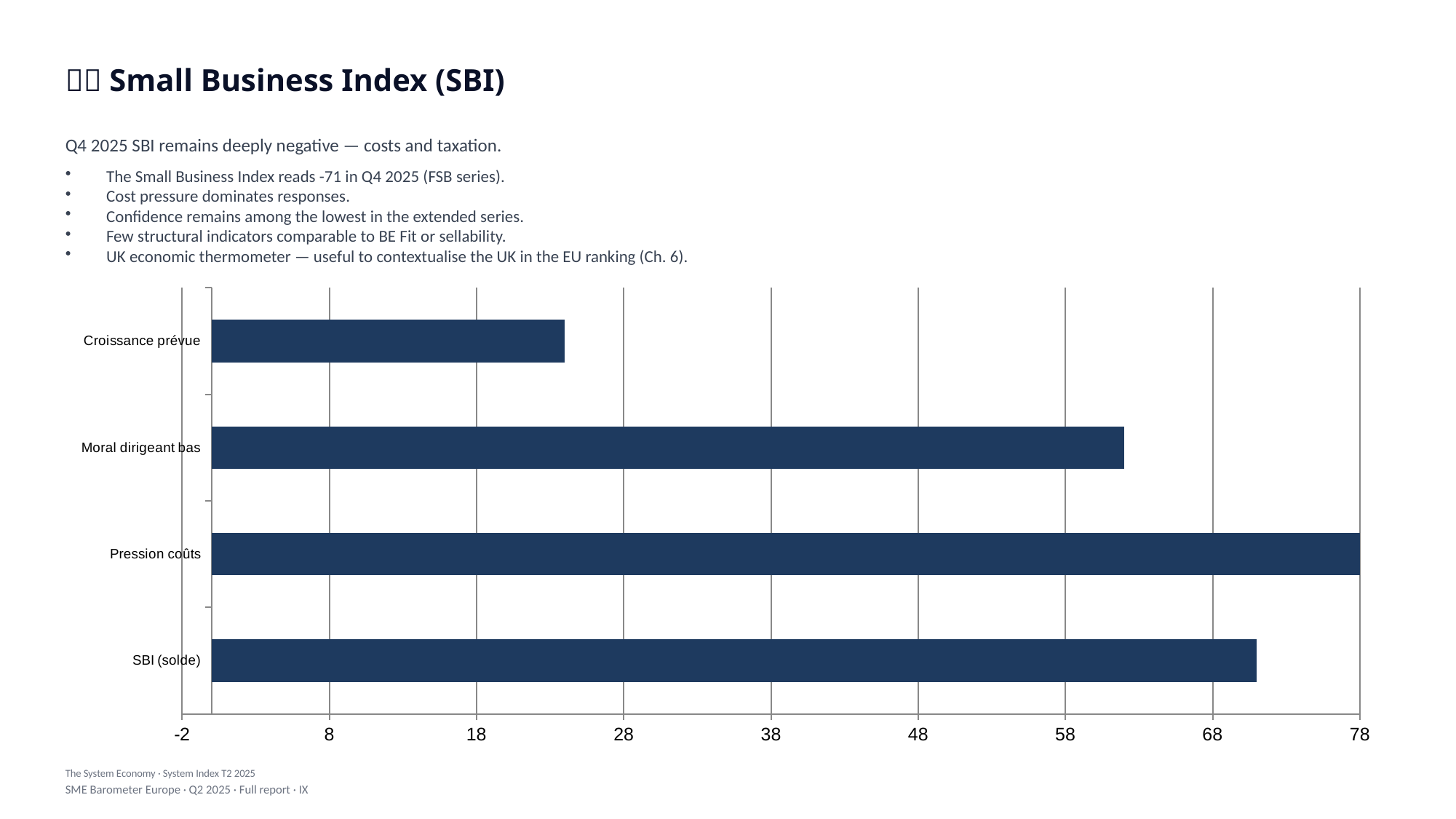
Is the value for Croissance prévue greater or less than 18? greater What is the lowest tick value shown on the x axis of the chart? -2 Is the value for Moral dirigeant bas greater or less than 58? greater What kind of chart is shown on the slide? bar chart Is the value for SBI (solde) greater or less than 68? greater Which category has the longest bar in the chart? Pression coûts Which is larger, the value for Moral dirigeant bas or the value for SBI (solde)? SBI (solde) What is the highest tick value shown on the x axis of the chart? 78 How many categories are plotted in the chart? 4 Which category has the shortest bar in the chart? Croissance prévue Which is larger, the value for Croissance prévue or the value for Pression coûts? Pression coûts